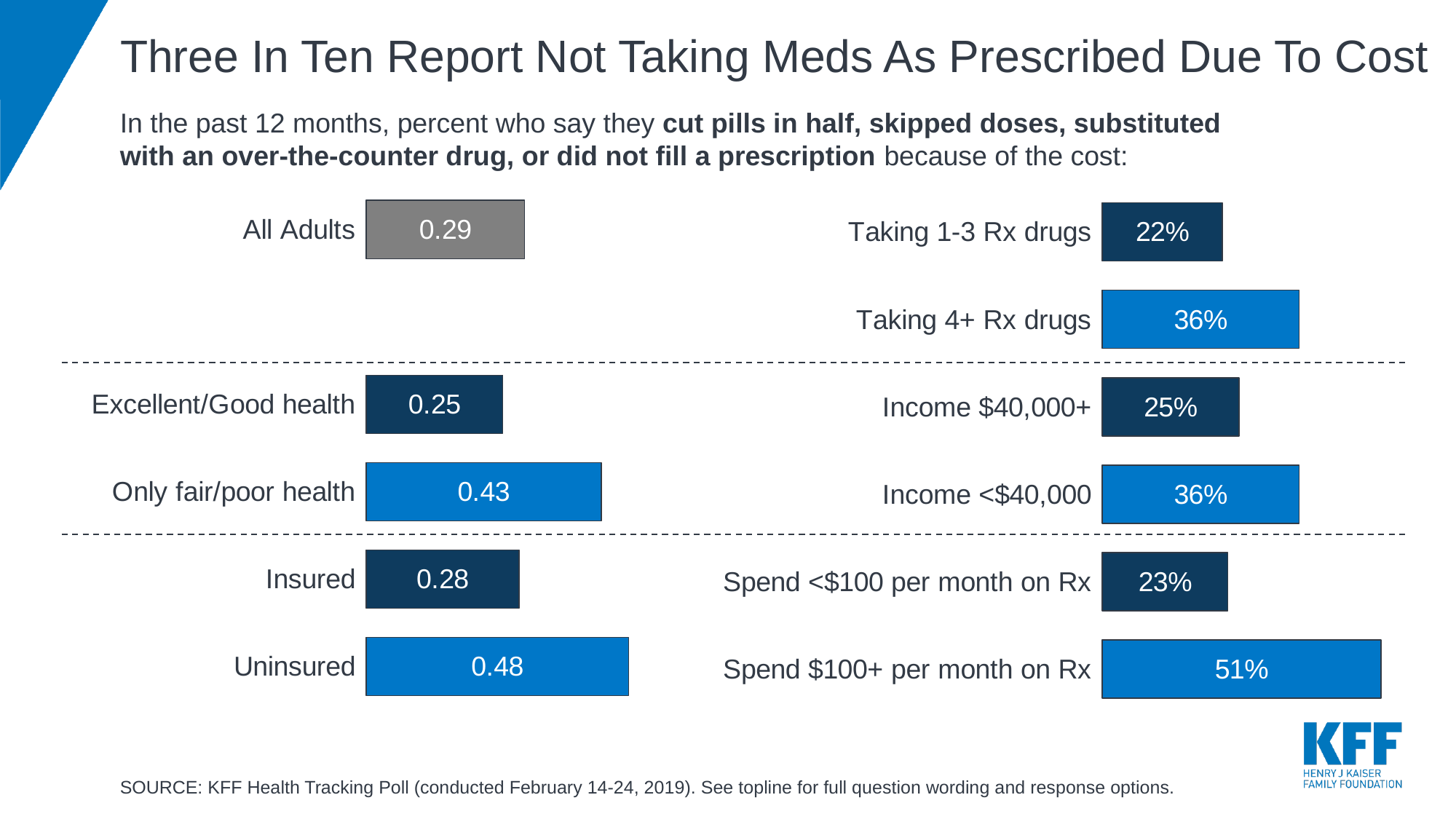
On the right chart, what is the value for Spend $100+ per month on Rx? 51% On the left chart, which category has the lowest value? Excellent/Good health On the right chart, which category has the lowest value? Taking 1-3 Rx drugs On the left chart, what is the difference between the values for Uninsured and Insured? 0.20 How many categories are shown on the right chart? 6 On the right chart, what is the value for Taking 1-3 Rx drugs? 22% What kind of chart is the left chart? Bar chart On the left chart, which category has the highest value? Uninsured On the right chart, what is the difference between the values for Income <$40,000 and Income $40,000+? 11% On the left chart, what is the value for All Adults? 0.29 On the left chart, which is larger, the value for Only fair/poor health or the value for Excellent/Good health? Only fair/poor health On the left chart, what is the value for Uninsured? 0.48